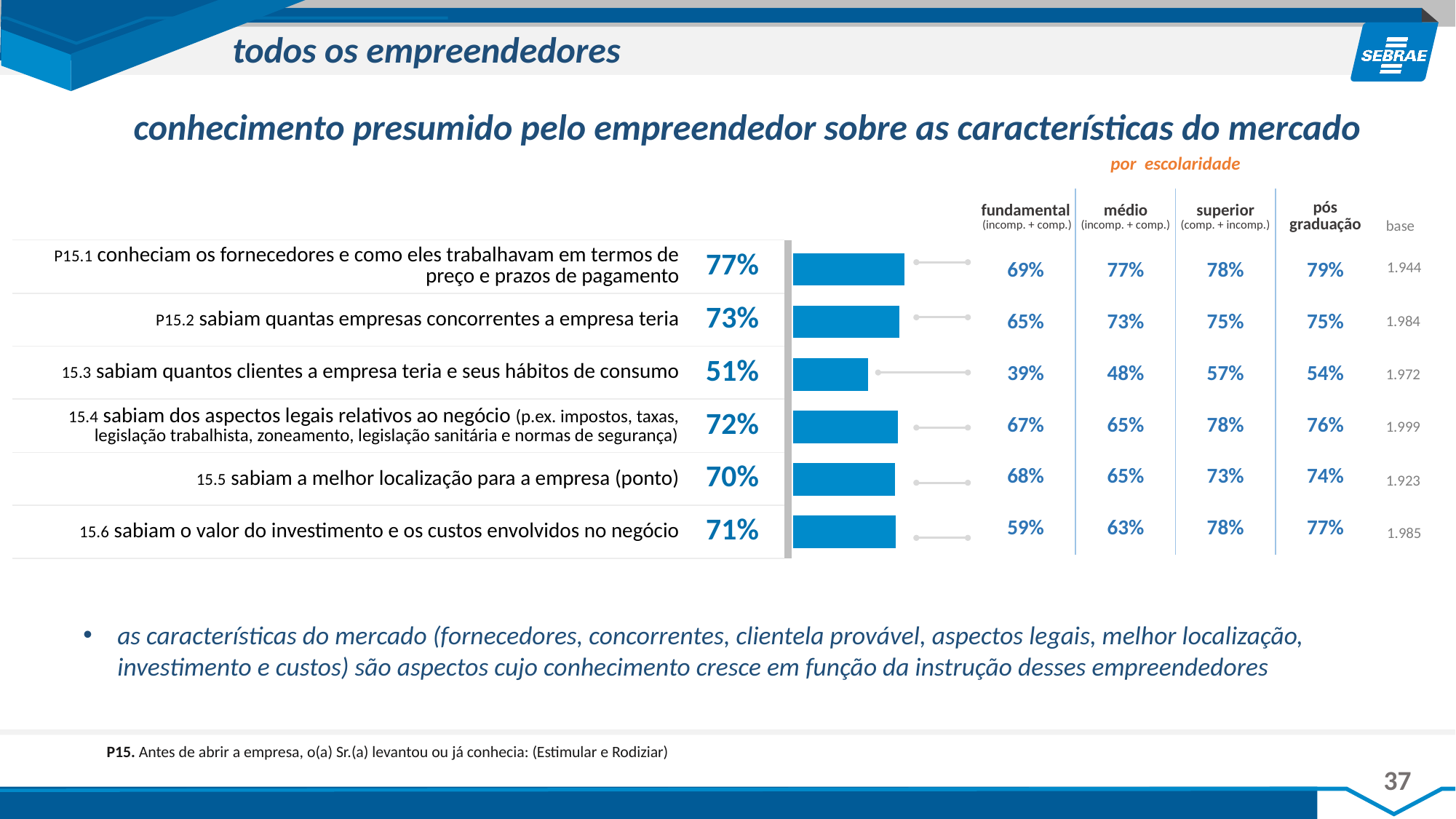
What is the difference in percentage points between the overall values for P15.1 (77%) and 15.3 (51%)? 26 percentage points In the 'pós graduação' column, what is the value for P15.1? 79% How many items (bars) are shown in the bar chart? 6 What is the overall value shown for item 15.3, knowing how many clients the company would have and their consumption habits? 51% What is the title of the chart on the slide? conhecimento presumido pelo empreendedor sobre as características do mercado Which has a higher overall value: 15.5 (best location) or 15.6 (investment value and costs)? 15.6 sabiam o valor do investimento e os custos envolvidos no negócio Which item has the highest overall percentage in the bar chart? P15.1 conheciam os fornecedores e como eles trabalhavam em termos de preço e prazos de pagamento Which item has the lowest overall percentage in the bar chart? 15.3 sabiam quantos clientes a empresa teria e seus hábitos de consumo What percentage of entrepreneurs knew the suppliers and how they worked in terms of price and payment terms (P15.1)? 77% In the 'fundamental' education column, what is the value for item 15.3? 39% What type of chart is used to display the overall percentages? Bar chart What is the base (number of respondents) shown for item 15.4? 1.999